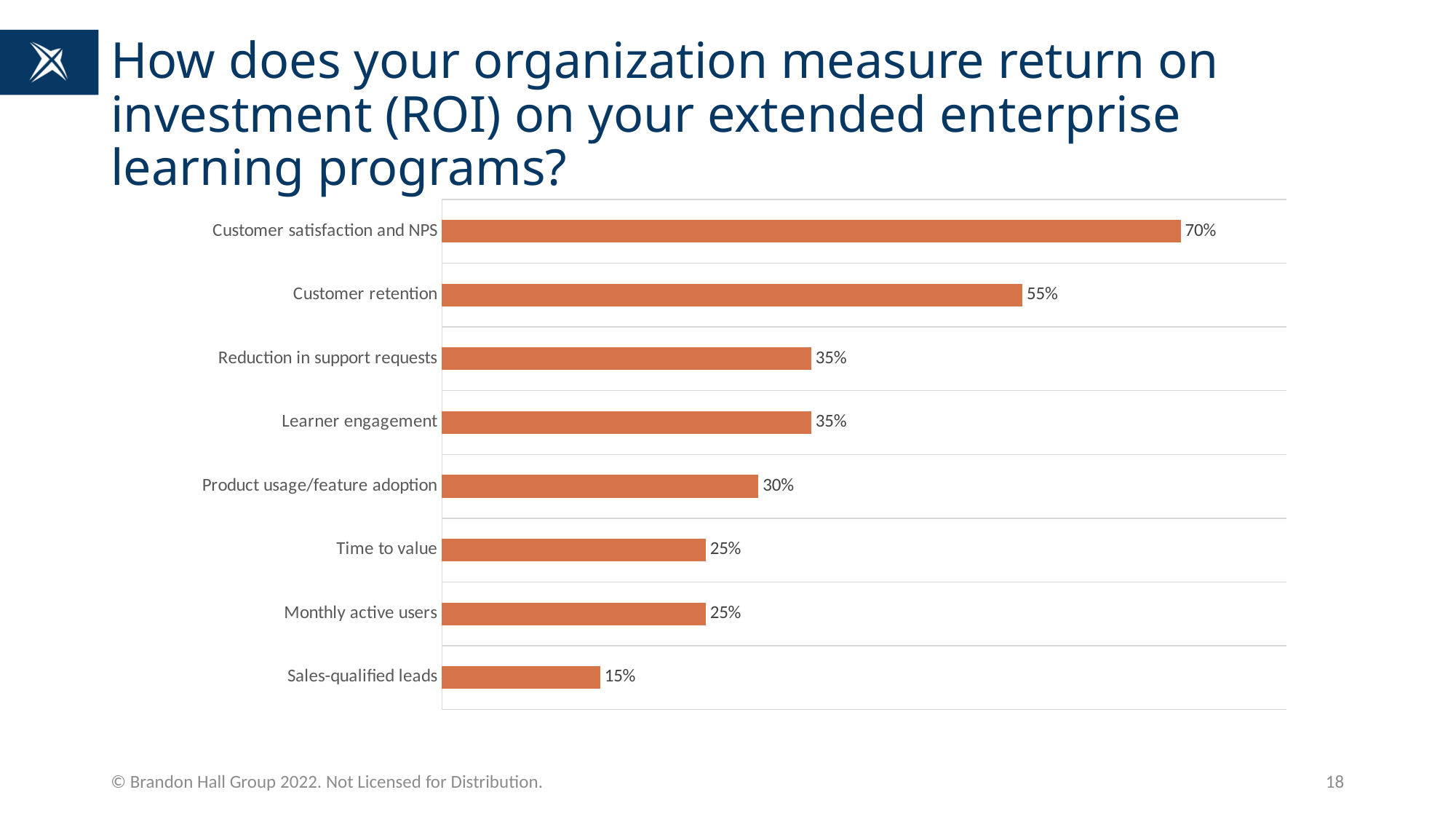
What is the value shown for Product usage/feature adoption? 30% Which category has the highest value? Customer satisfaction and NPS Which is larger, the value for Customer retention or the value for Reduction in support requests? Customer retention What kind of chart is shown on the slide? Bar chart What is the difference between the values for Customer satisfaction and NPS and Customer retention? 15% What is the difference between the values for Learner engagement and Sales-qualified leads? 20% What is the value shown for Sales-qualified leads? 15% What colour are the bars in the chart? Orange What percentage of organizations measure ROI using customer satisfaction and NPS? 70% How many categories are shown in the chart? 8 Which category has the lowest value? Sales-qualified leads What is the value shown for Customer retention? 55%